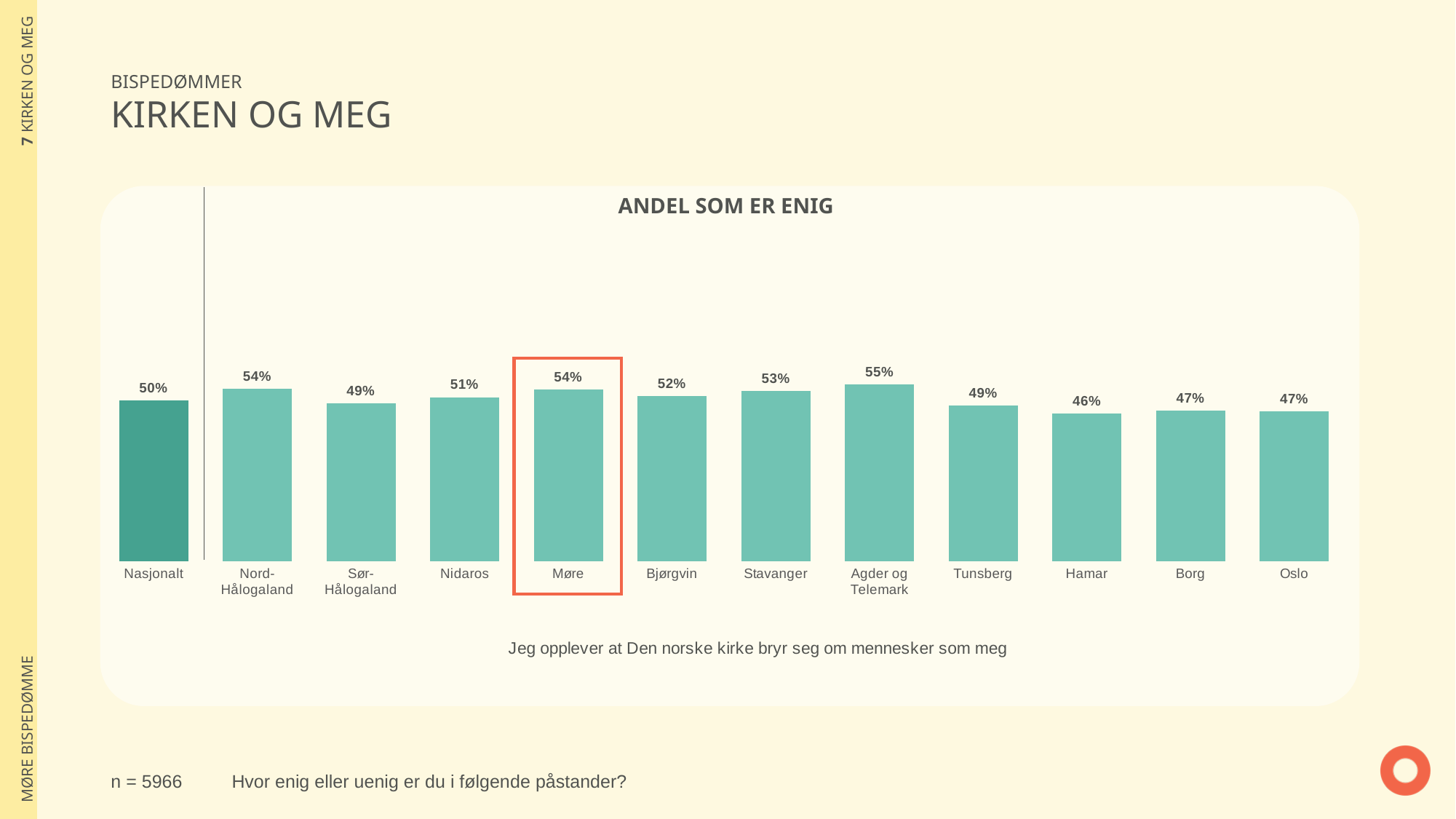
What is the difference between the values for Agder og Telemark and Hamar? 9% Which category has the lowest value in the chart? Hamar Which is larger, the value for Stavanger or the value for Tunsberg? Stavanger Which category has the highest value in the chart? Agder og Telemark What is the value for Møre in the chart? 54% How many categories are shown in the chart? 12 What is the value for Agder og Telemark? 55% What is the value for Nasjonalt in the chart? 50% What is the value for Hamar? 46% What is the title of the chart? ANDEL SOM ER ENIG What is the difference between the values for Møre and Nasjonalt? 4% What kind of chart is shown on the slide? Bar chart